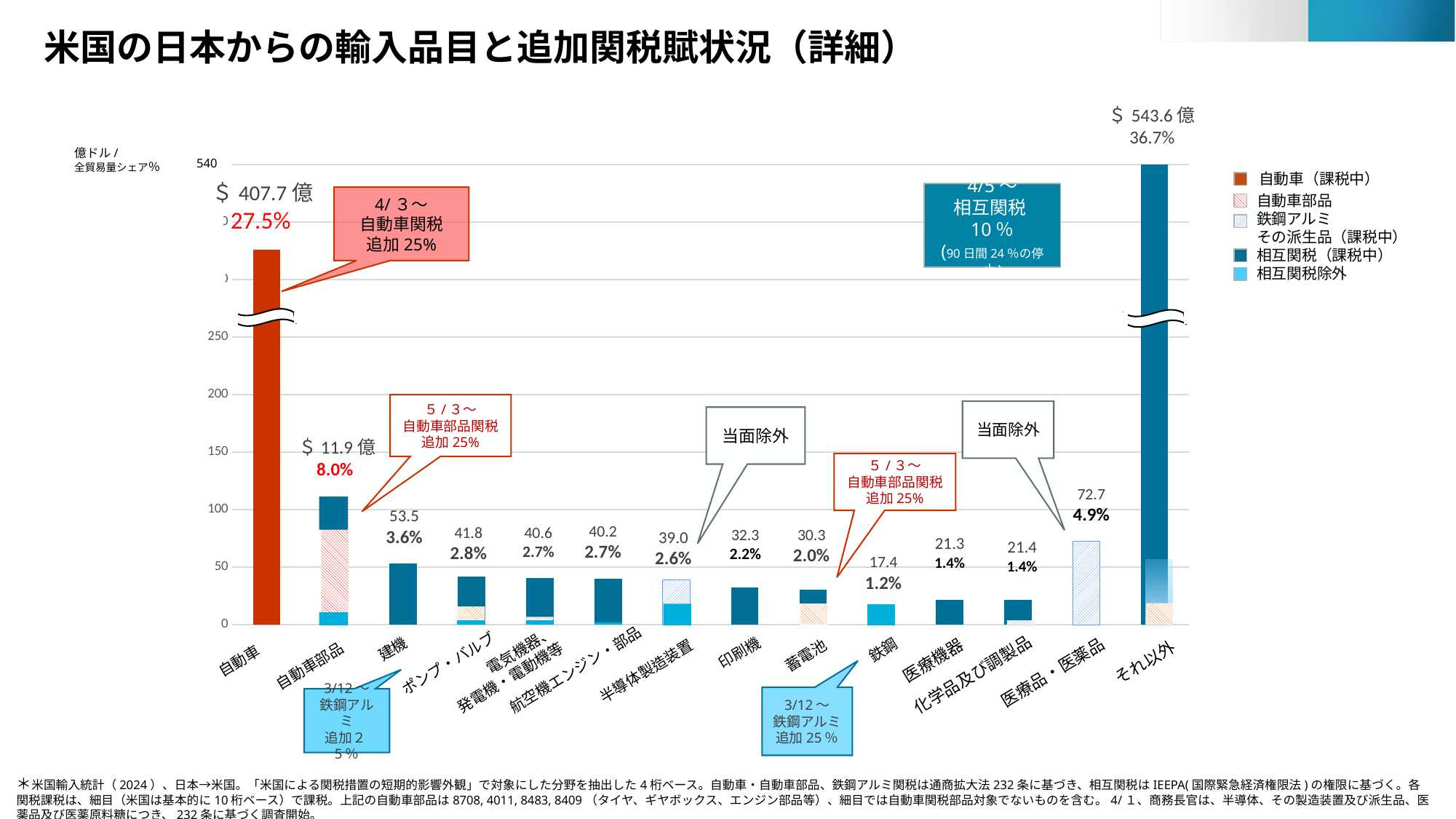
How many categories are shown on the x axis? 14 Which category has the highest value? それ以外 How many entries does the legend list? 5 What is the value shown for それ以外? $ 543.6 億 Which category has the lowest value? 鉄鋼 What is the difference between the values for 建機 and 半導体製造装置? 14.5 What kind of chart is shown on the slide? bar chart What share of total trade is shown for 自動車? 27.5% Is the value for 自動車 greater or less than 250? greater What share of total trade is shown for 医療品・医薬品? 4.9% Which has the larger value, 印刷機 or 蓄電池? 印刷機 What is the value shown for 建機? 53.5